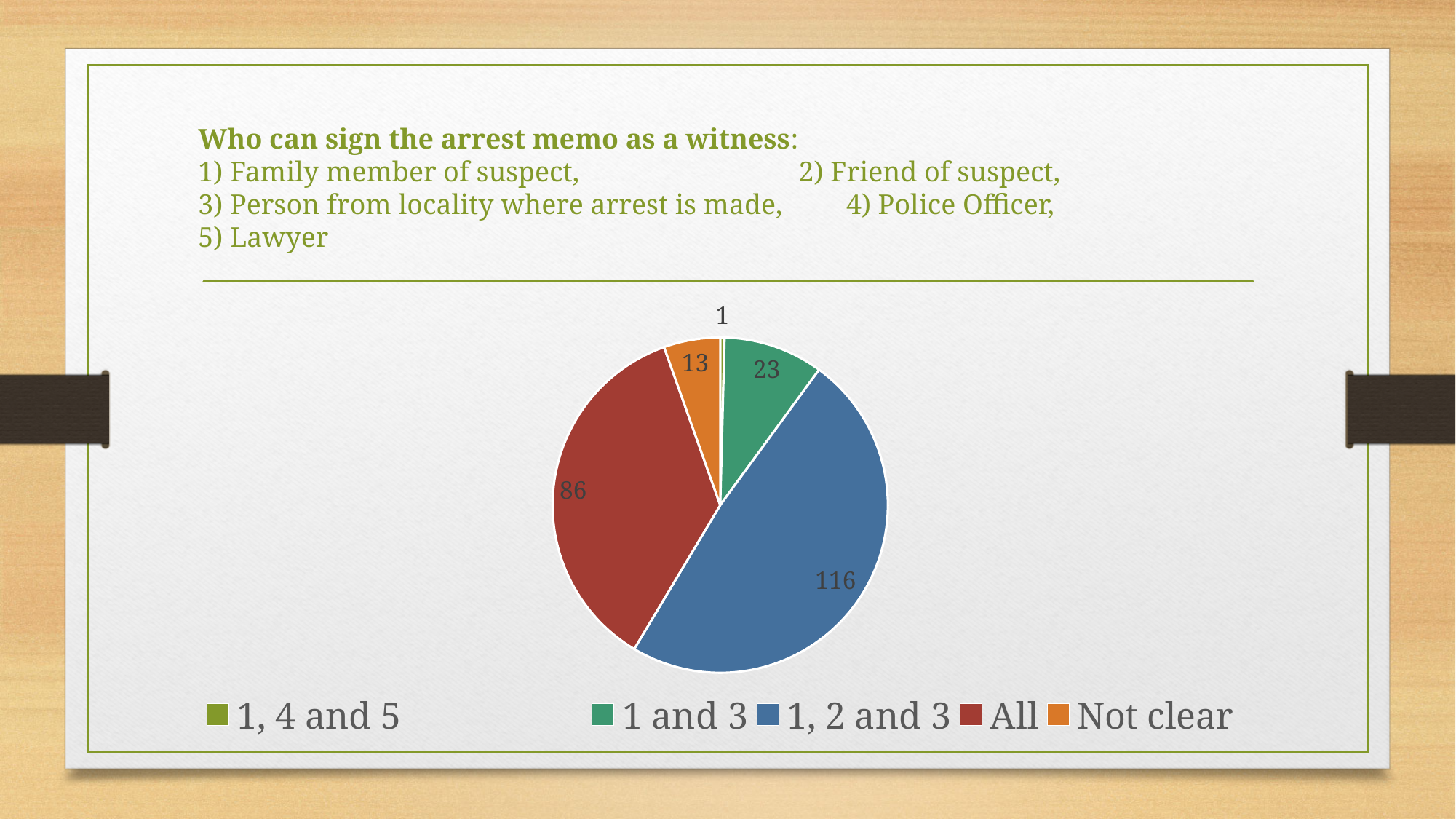
What is the total of all the slice values in the pie chart? 239 Which category has the largest slice of the pie? 1, 2 and 3 Which is larger, the '1 and 3' slice or the 'Not clear' slice? 1 and 3 What is the value for the '1 and 3' slice? 23 What is the difference between the '1, 2 and 3' value and the 'All' value? 30 Which category has the smallest slice of the pie? 1, 4 and 5 What is the value for the 'All' slice? 86 What is the value for the '1, 2 and 3' slice? 116 What is the value for the 'Not clear' slice? 13 What type of chart is shown on the slide? pie chart How many categories does the pie chart have? 5 What is the value for the '1, 4 and 5' slice? 1